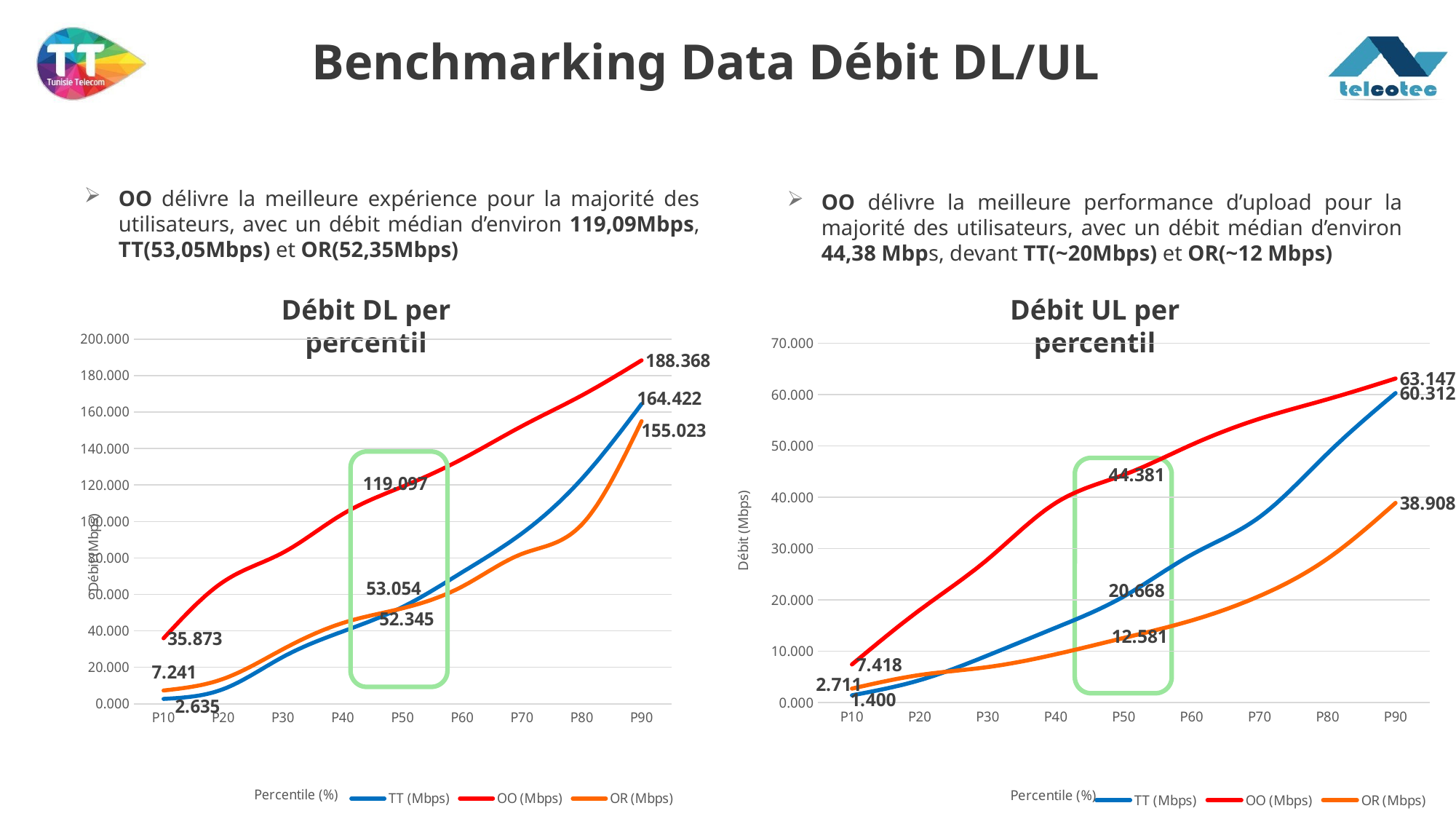
In the 'Débit UL per percentil' chart, which series has the highest value at P90? OO (Mbps) How many percentile categories are shown on the x axis of the 'Débit UL per percentil' chart? 9 In the 'Débit DL per percentil' chart, is the value for OO (Mbps) at P70 greater or less than 140.000? greater In the 'Débit DL per percentil' chart, which series has the lowest value at P10? TT (Mbps) In the 'Débit DL per percentil' chart, what is the difference between OO (Mbps) and TT (Mbps) at P90? 23.946 In the 'Débit DL per percentil' chart, do the values for OR (Mbps) rise or fall from P10 to P90? Rise In the 'Débit UL per percentil' chart, what is the value of TT (Mbps) at P90? 60.312 In the 'Débit UL per percentil' chart, which is larger at P50: TT (Mbps) or OR (Mbps)? TT (Mbps) What kind of chart is the 'Débit UL per percentil' chart? Line chart How many series does the legend of the 'Débit DL per percentil' chart list? 3 In the 'Débit DL per percentil' chart, what is the value of OO (Mbps) at P50? 119.097 In the 'Débit DL per percentil' chart, what is the value of OR (Mbps) at P10? 7.241